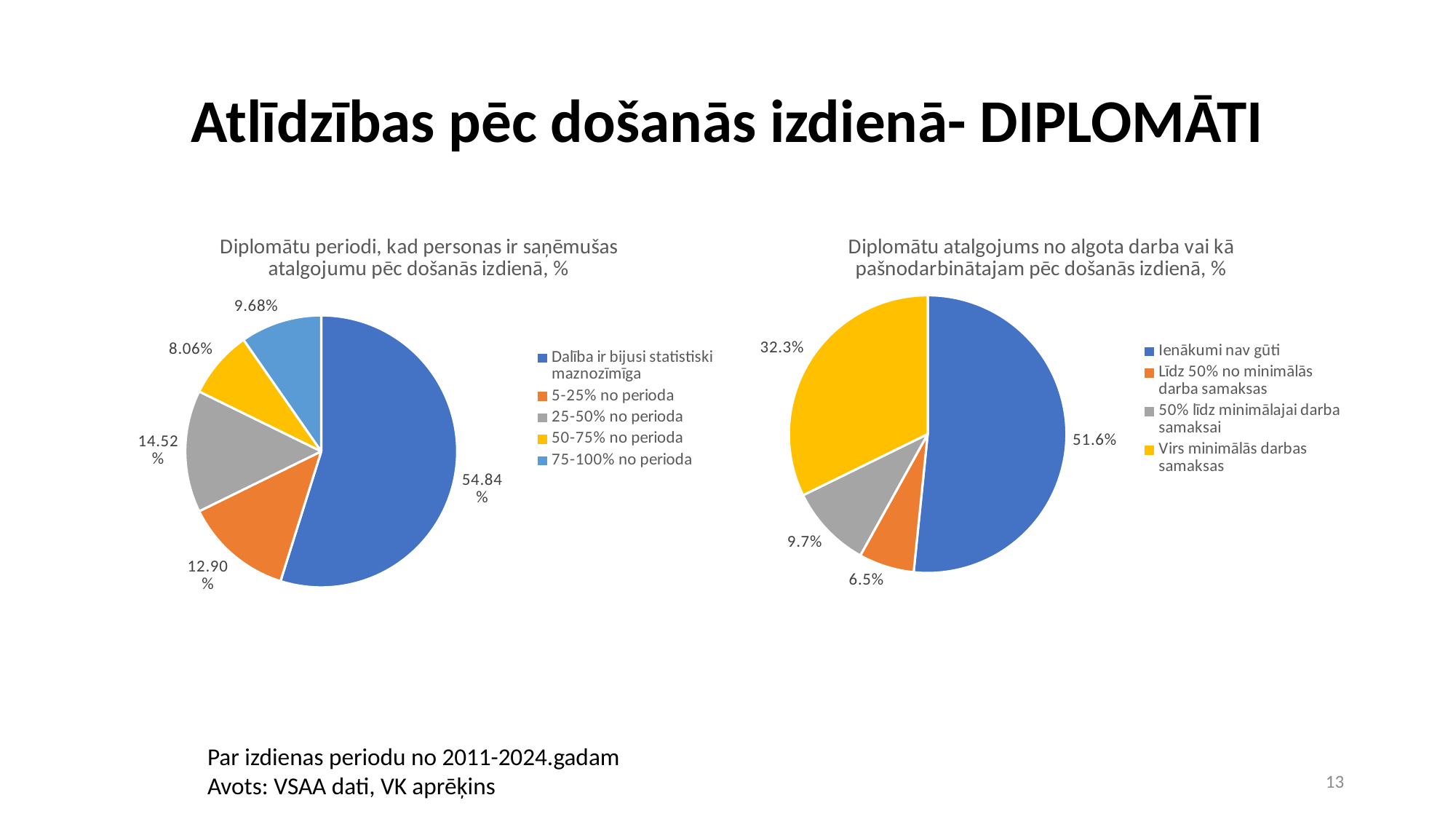
In the right chart (Diplomātu atalgojums...), how many categories does the legend list? 4 What type of chart is used for both charts on the slide? Pie chart In the right chart (Diplomātu atalgojums no algota darba vai kā pašnodarbinātajam pēc došanās izdienā, %), what share is labelled for 'Ienākumi nav gūti'? 51.6% In the right chart (Diplomātu atalgojums...), what share is labelled for 'Virs minimālās darbas samaksas'? 32.3% In the left chart (Diplomātu periodi...), what is the difference between the shares for '25-50% no perioda' and '5-25% no perioda'? 1.62% In the right chart (Diplomātu atalgojums...), what is the difference between the shares for 'Ienākumi nav gūti' and 'Virs minimālās darbas samaksas'? 19.3% In the left chart (Diplomātu periodi...), what share is labelled for '25-50% no perioda'? 14.52% In the left chart (Diplomātu periodi...), how many slices does the pie have? 5 In the left chart (Diplomātu periodi, kad personas ir saņēmušas atalgojumu pēc došanās izdienā, %), what share is labelled for 'Dalība ir bijusi statistiski maznozīmīga'? 54.84% In the right chart (Diplomātu atalgojums...), which category has the smallest slice? Līdz 50% no minimālās darba samaksas In the left chart (Diplomātu periodi...), which is larger: '5-25% no perioda' or '75-100% no perioda'? 5-25% no perioda In the left chart (Diplomātu periodi...), which category has the smallest slice? 50-75% no perioda